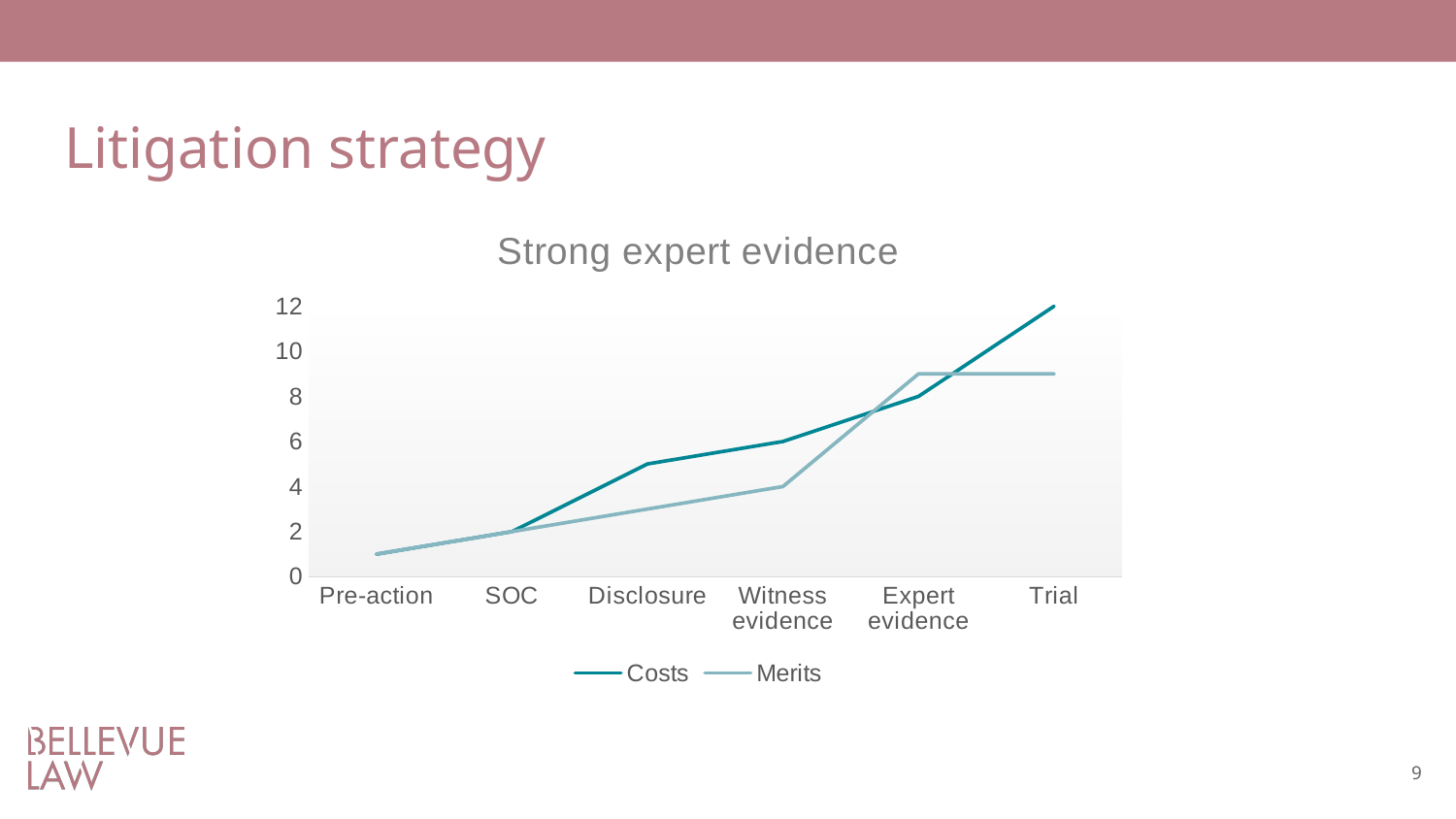
What is the value of Merits at Witness evidence? 4 Is the value of Costs at Disclosure greater or less than 4? greater What kind of chart is shown on the slide? Line chart Do the Costs values rise or fall from Pre-action to Trial? Rise How many series does the legend list? 2 At Trial, which series has the larger value, Costs or Merits? Costs What is the value of Costs at Expert evidence? 8 What is the title of the chart? Strong expert evidence Is the value of Merits at Expert evidence greater or less than 8? greater At which stage is Costs highest? Trial How many stages are shown along the x axis? 6 What is the value of Costs at Trial? 12